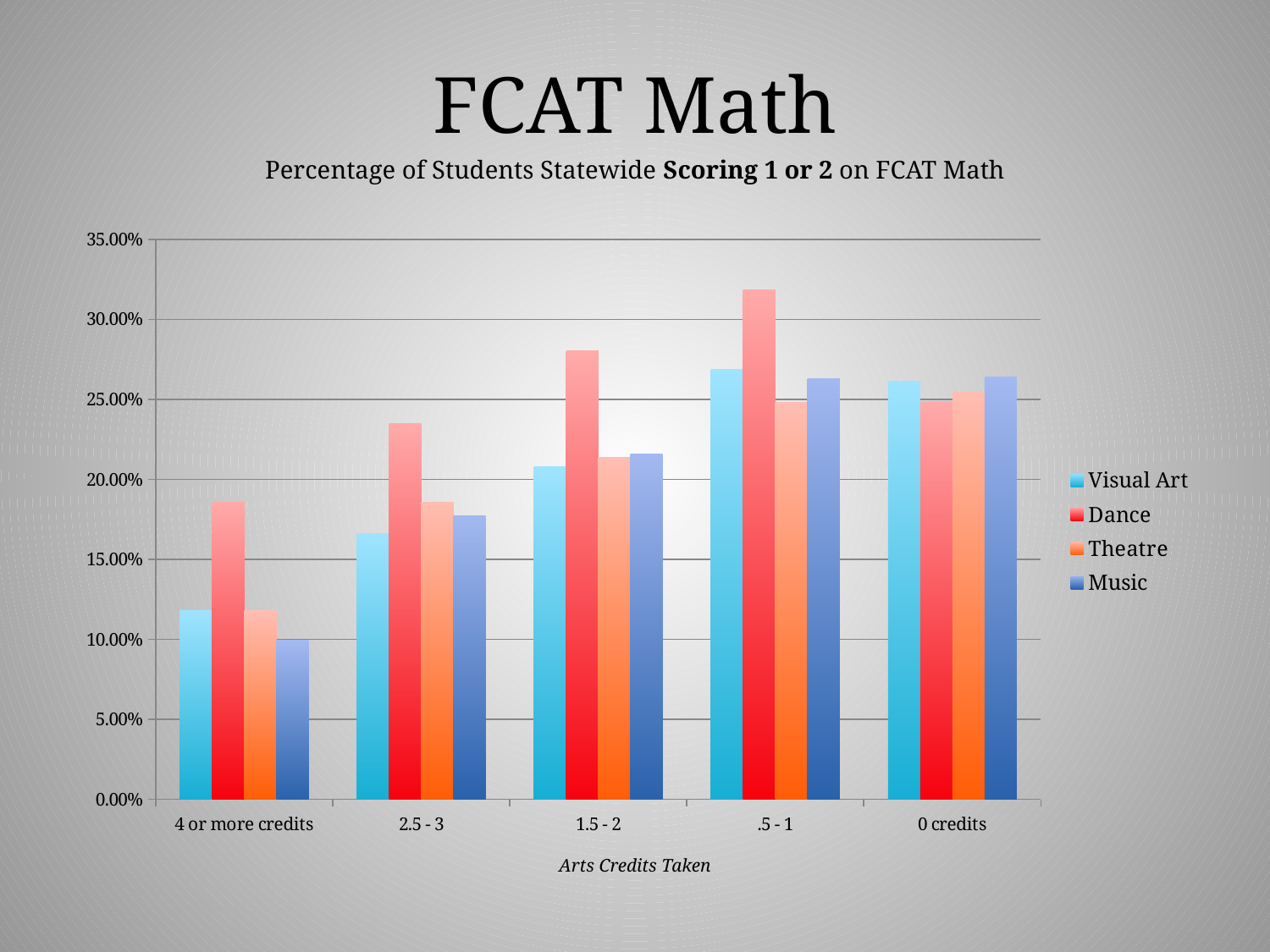
What kind of chart is shown on the slide? bar chart How many series does the legend list? 4 For 0 credits, which is larger, the Music value or the Dance value? Music Is the Music value for 4 or more credits greater or less than 15.00%? less For 2.5 - 3 credits, which is larger, the Dance value or the Visual Art value? Dance What is the title of the x axis? Arts Credits Taken Do the Dance values rise or fall from 4 or more credits to .5 - 1 credits? rise Is the Dance value for .5 - 1 credits greater or less than 30.00%? greater In which arts-credit category is the Music bar lowest? 4 or more credits Is the Dance value for 1.5 - 2 credits greater or less than 25.00%? greater In which arts-credit category is the Dance bar highest? .5 - 1 How many arts-credit categories are shown on the x axis? 5